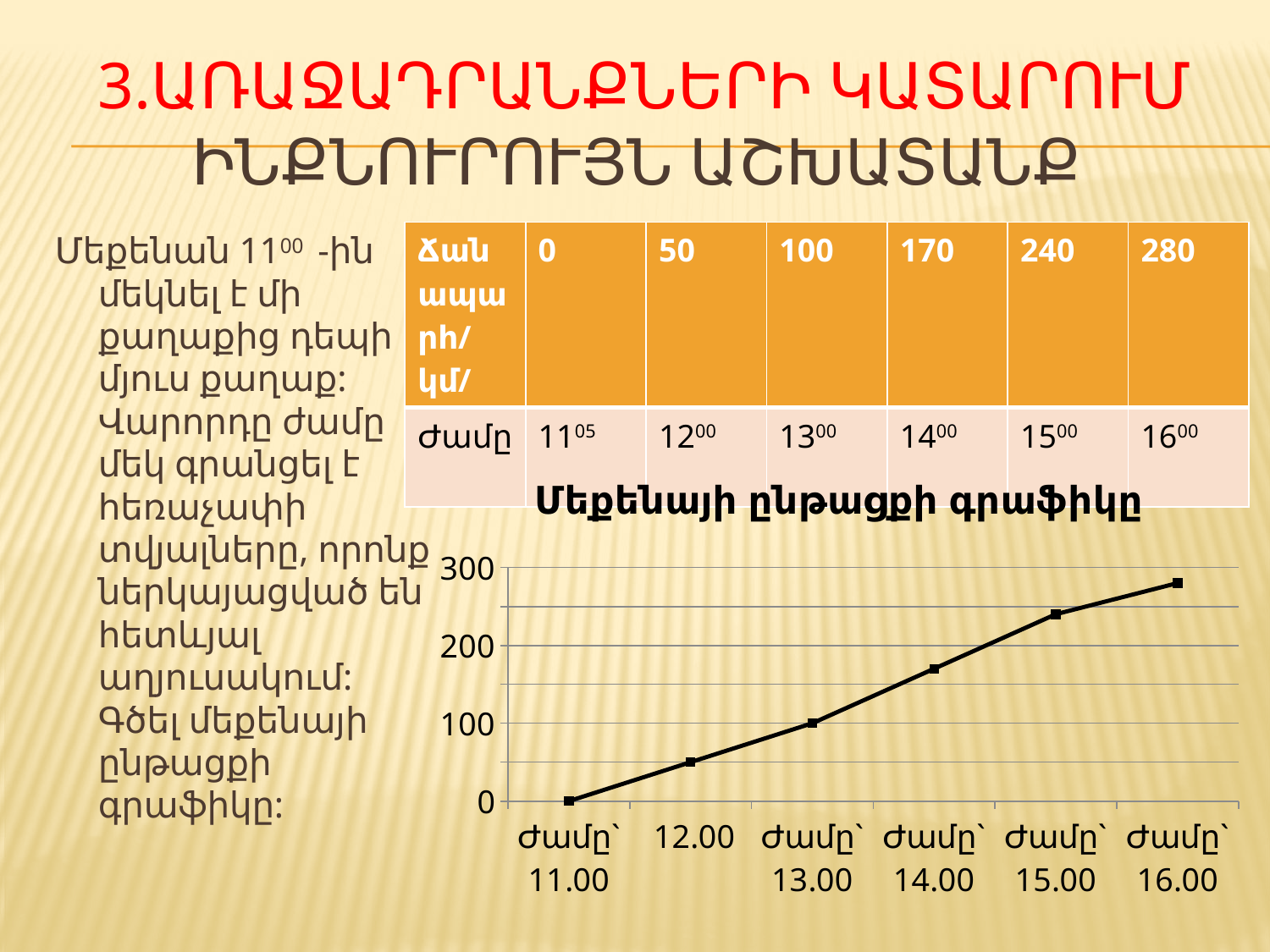
How many data points are plotted on the line chart? 6 What is the title of the line chart? Մեքենայի ընթացքի գրաֆիկը At which time is the plotted value lowest on the line chart? Ժամը` 11.00 Do the values on the line chart rise or fall from 11.00 to 16.00? rise Is the value for 12.00 on the line chart greater or less than 100? less At which time is the plotted value highest on the line chart? Ժամը` 16.00 Which has the larger plotted value on the line chart, Ժամը` 15.00 or 12.00? Ժամը` 15.00 What is the plotted value at Ժամը` 11.00 on the line chart? 0 What kind of chart is shown on the slide? line chart What is the plotted value at Ժամը` 13.00 on the line chart? 100 Is the value for Ժամը` 15.00 on the line chart greater or less than 200? greater Is the value for Ժամը` 14.00 on the line chart greater or less than 200? less